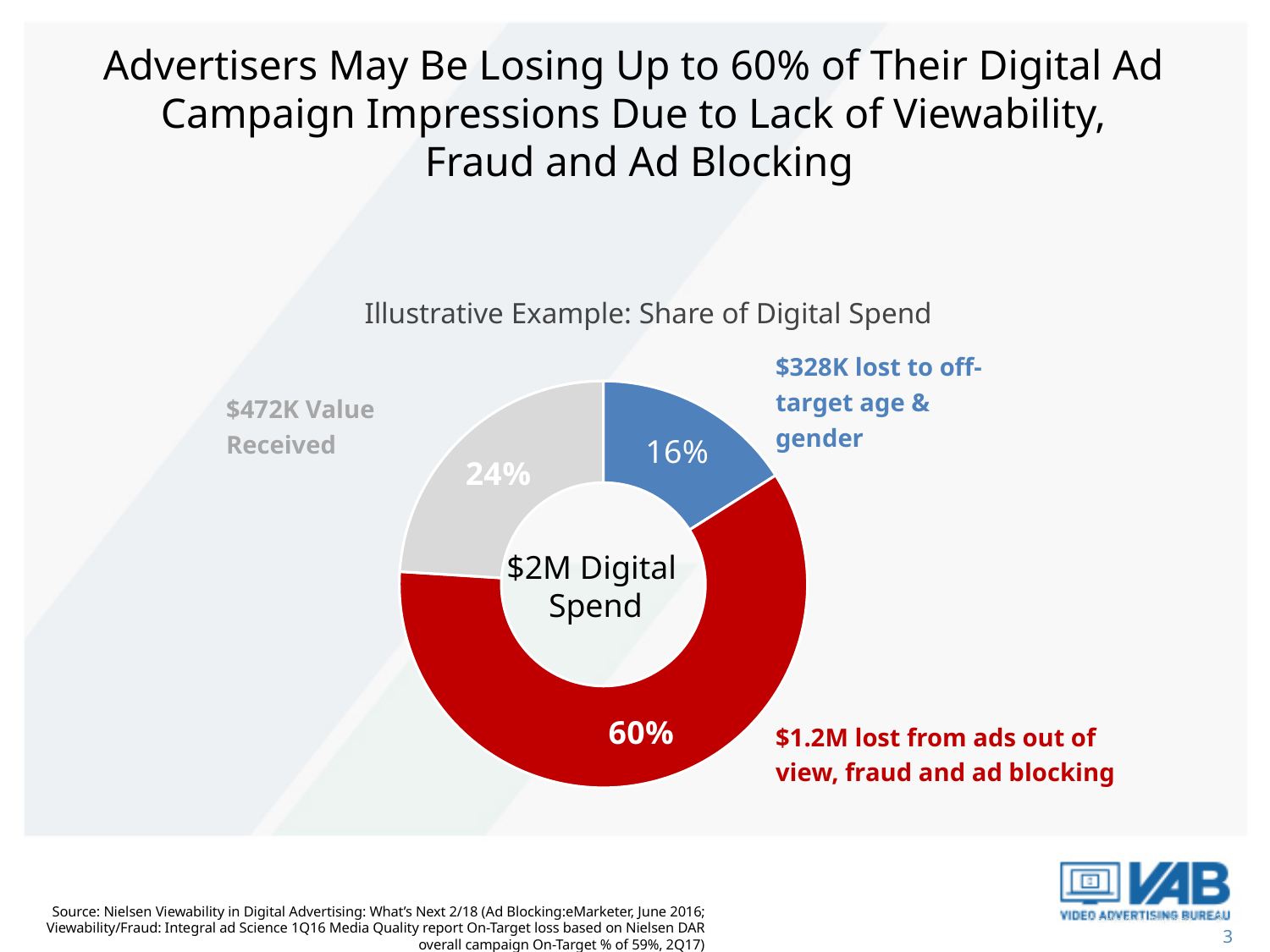
What share of digital spend is shown as value received? 24% What share of digital spend is lost from ads out of view, fraud and ad blocking? 60% Which slice of the chart is the largest? Lost from ads out of view, fraud and ad blocking (60%) What is the title of the chart? Illustrative Example: Share of Digital Spend What share of digital spend is lost to off-target age & gender? 16% How many slices does the chart have? 3 Which slice of the chart is the smallest? Lost to off-target age & gender (16%) What kind of chart is shown on the slide? Pie chart (donut) Which is larger: the share of value received or the share lost to off-target age & gender? Value received (24%) What dollar amount is labeled as lost from ads out of view, fraud and ad blocking? $1.2M What is the difference in percentage points between the share lost to out-of-view, fraud and ad blocking and the share of value received? 36 percentage points What total digital spend is shown in the center of the chart? $2M Digital Spend